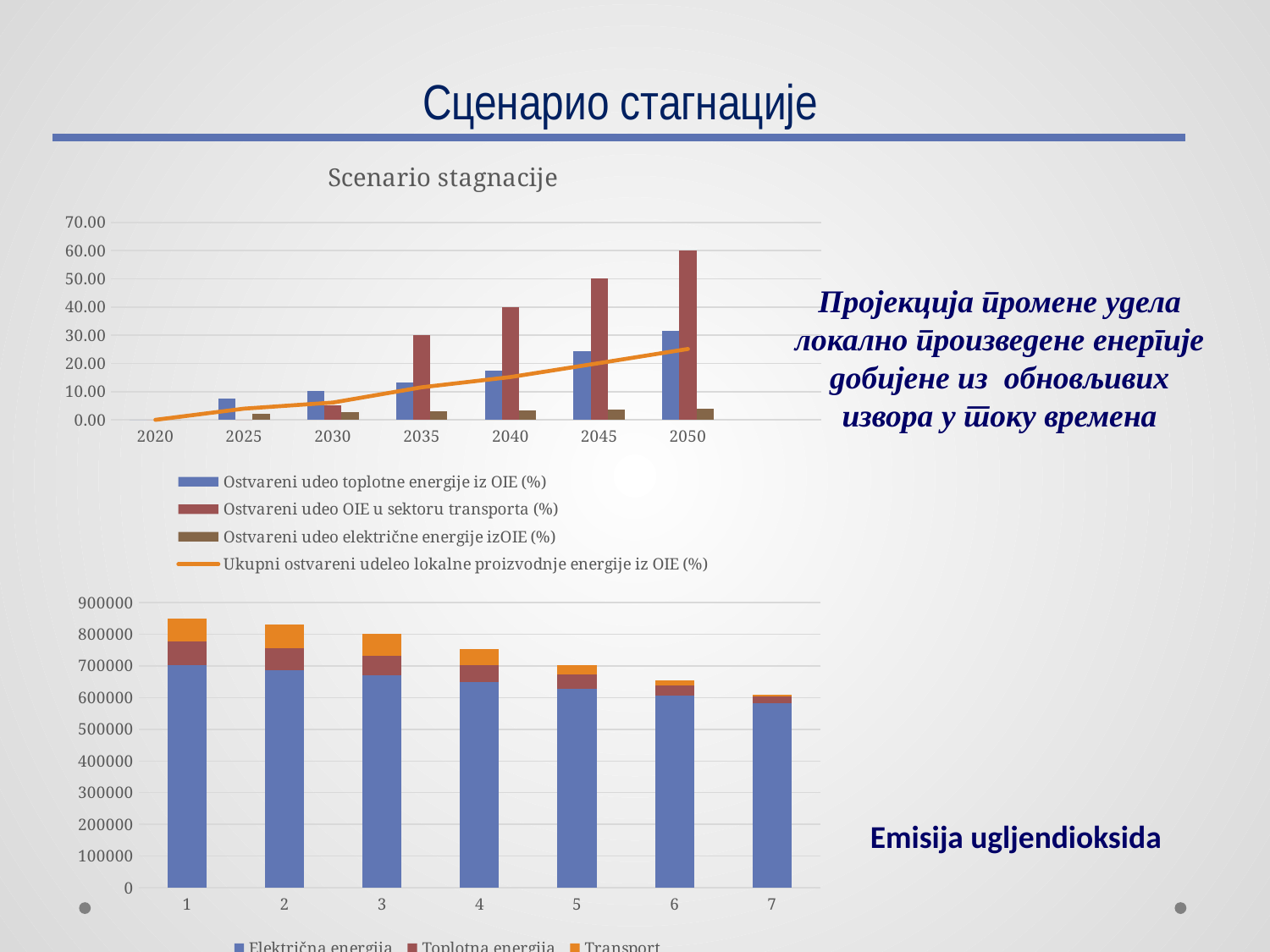
In the bottom chart, how many categories are shown on the x axis? 7 In the bottom chart, which category has the tallest stacked bar? 1 In the top chart titled 'Scenario stagnacije', is the value for 'Ostvareni udeo toplotne energije iz OIE (%)' in 2050 greater or less than 30.00? greater In the top chart titled 'Scenario stagnacije', how many series does the legend list? 4 In the top chart titled 'Scenario stagnacije', does the line 'Ukupni ostvareni udeleo lokalne proizvodnje energije iz OIE (%)' rise or fall from 2020 to 2050? rise In the top chart titled 'Scenario stagnacije', is the value for 'Ostvareni udeo OIE u sektoru transporta (%)' in 2050 greater or less than 50.00? greater In the bottom chart, is the value for 'Električna energija' in category 7 greater or less than 600000? less In the top chart titled 'Scenario stagnacije', which is larger in 2040: 'Ostvareni udeo OIE u sektoru transporta (%)' or 'Ostvareni udeo toplotne energije iz OIE (%)'? Ostvareni udeo OIE u sektoru transporta (%) In the top chart titled 'Scenario stagnacije', how many years are shown on the x axis? 7 What kind of chart is the bottom chart on the slide? stacked bar chart In the top chart titled 'Scenario stagnacije', which year has the highest value for 'Ostvareni udeo OIE u sektoru transporta (%)'? 2050